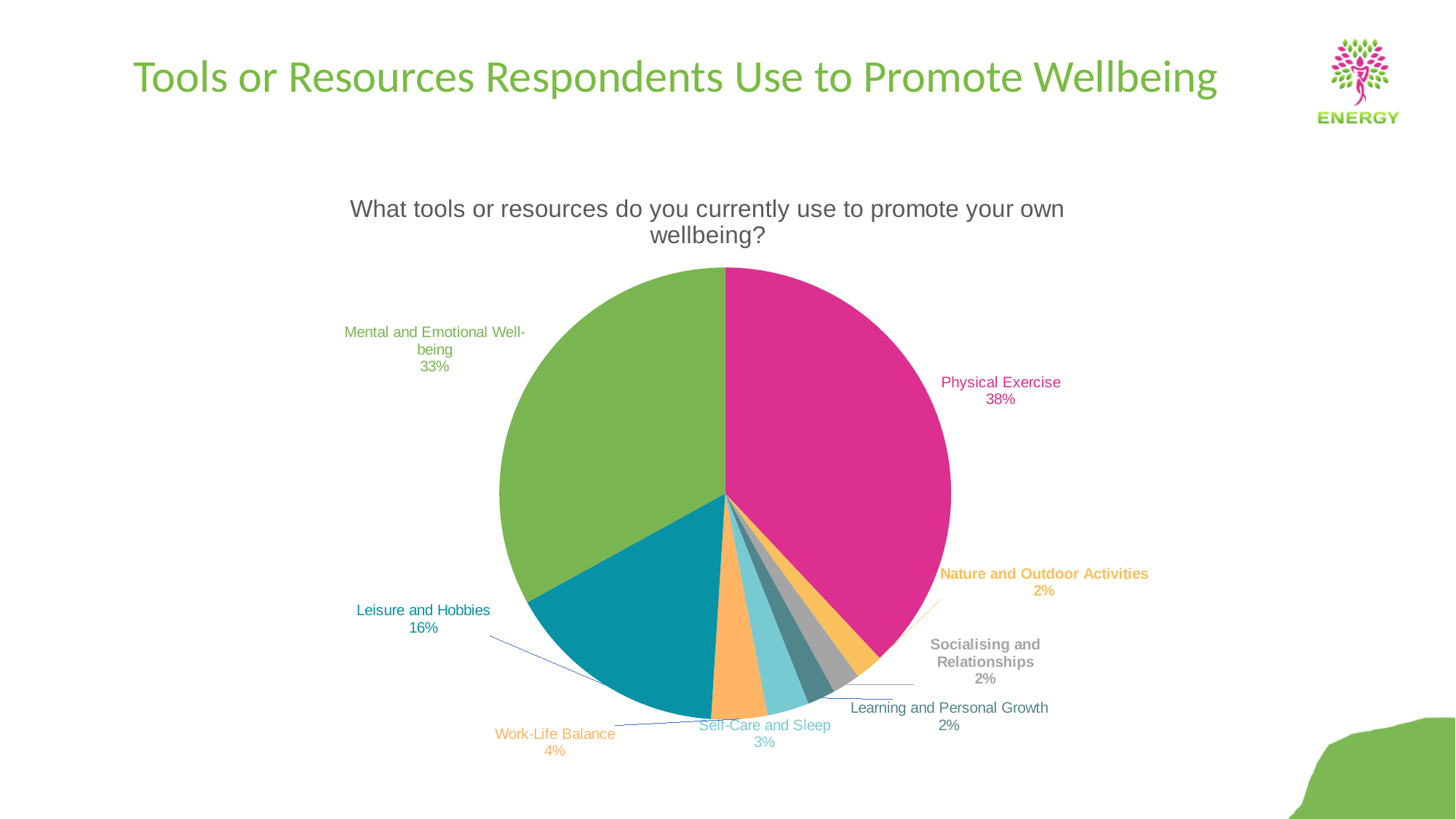
What percentage is shown for Work-Life Balance? 4% Which is larger, Leisure and Hobbies or Work-Life Balance? Leisure and Hobbies How many categories are shown in the pie chart? 8 What kind of chart is shown on the slide? Pie chart What percentage is shown for Mental and Emotional Well-being? 33% What is the title of the chart? What tools or resources do you currently use to promote your own wellbeing? What percentage is shown for Leisure and Hobbies? 16% What is the difference in percentage points between Physical Exercise and Mental and Emotional Well-being? 5 What percentage is shown for Self-Care and Sleep? 3% Which category has the largest slice of the pie? Physical Exercise What share of respondents use Physical Exercise to promote their wellbeing? 38% What is the combined percentage of Physical Exercise and Leisure and Hobbies? 54%